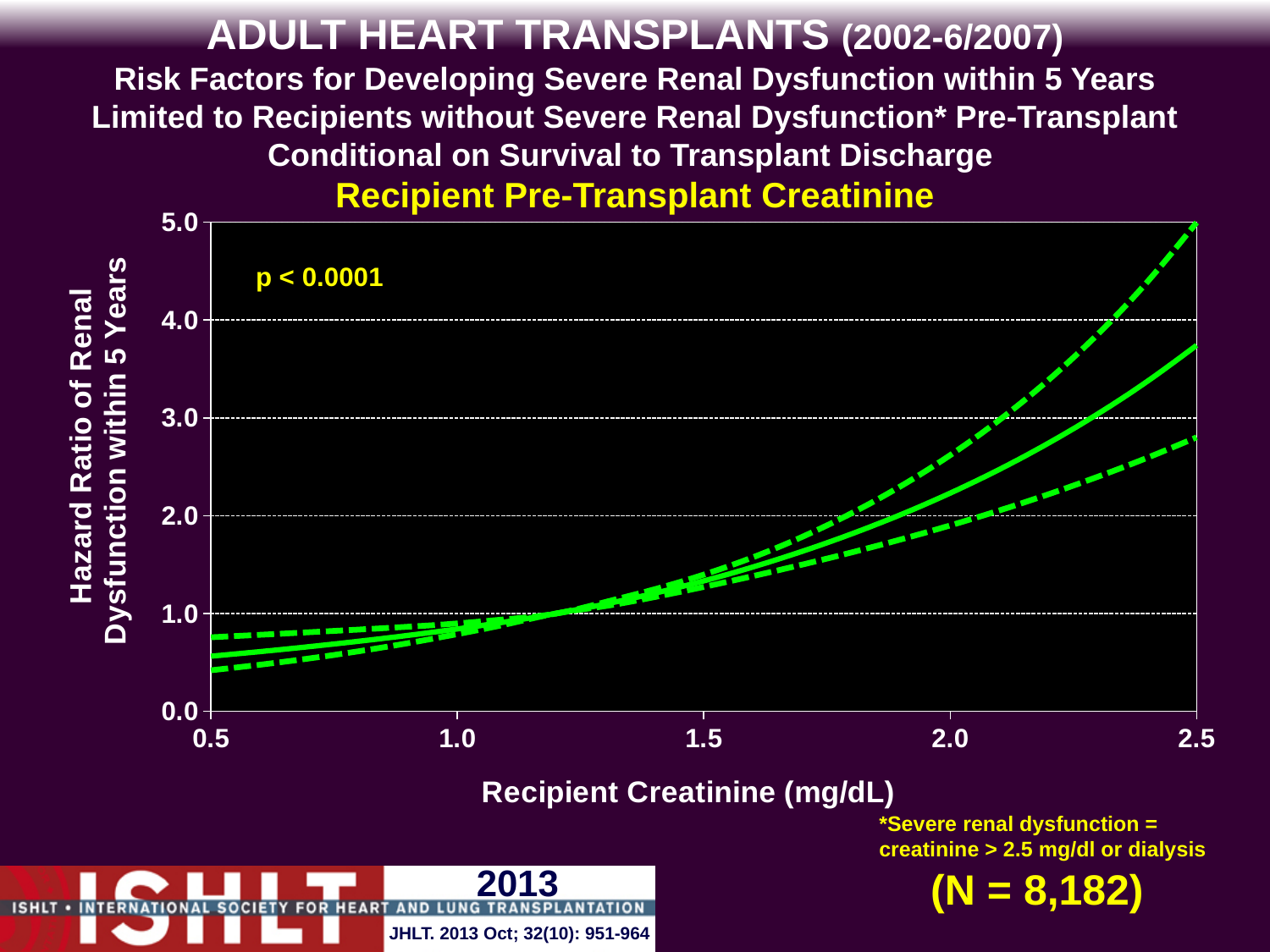
How many lines are plotted on the chart? 3 Is the hazard ratio on the solid line at a recipient creatinine of 2.5 mg/dL greater or less than 3.0? greater What is the sample size (N) shown on the slide? N = 8,182 Is the upper dashed line at a recipient creatinine of 2.5 mg/dL greater or less than 4.0? greater Does the hazard ratio rise or fall as recipient creatinine increases along the x axis? rise Is the hazard ratio on the solid line at a recipient creatinine of 0.5 mg/dL greater or less than 1.0? less What is the label of the x axis? Recipient Creatinine (mg/dL) What p-value is shown on the chart? p < 0.0001 What is the highest value shown on the y axis? 5.0 What kind of chart is shown on the slide? line chart